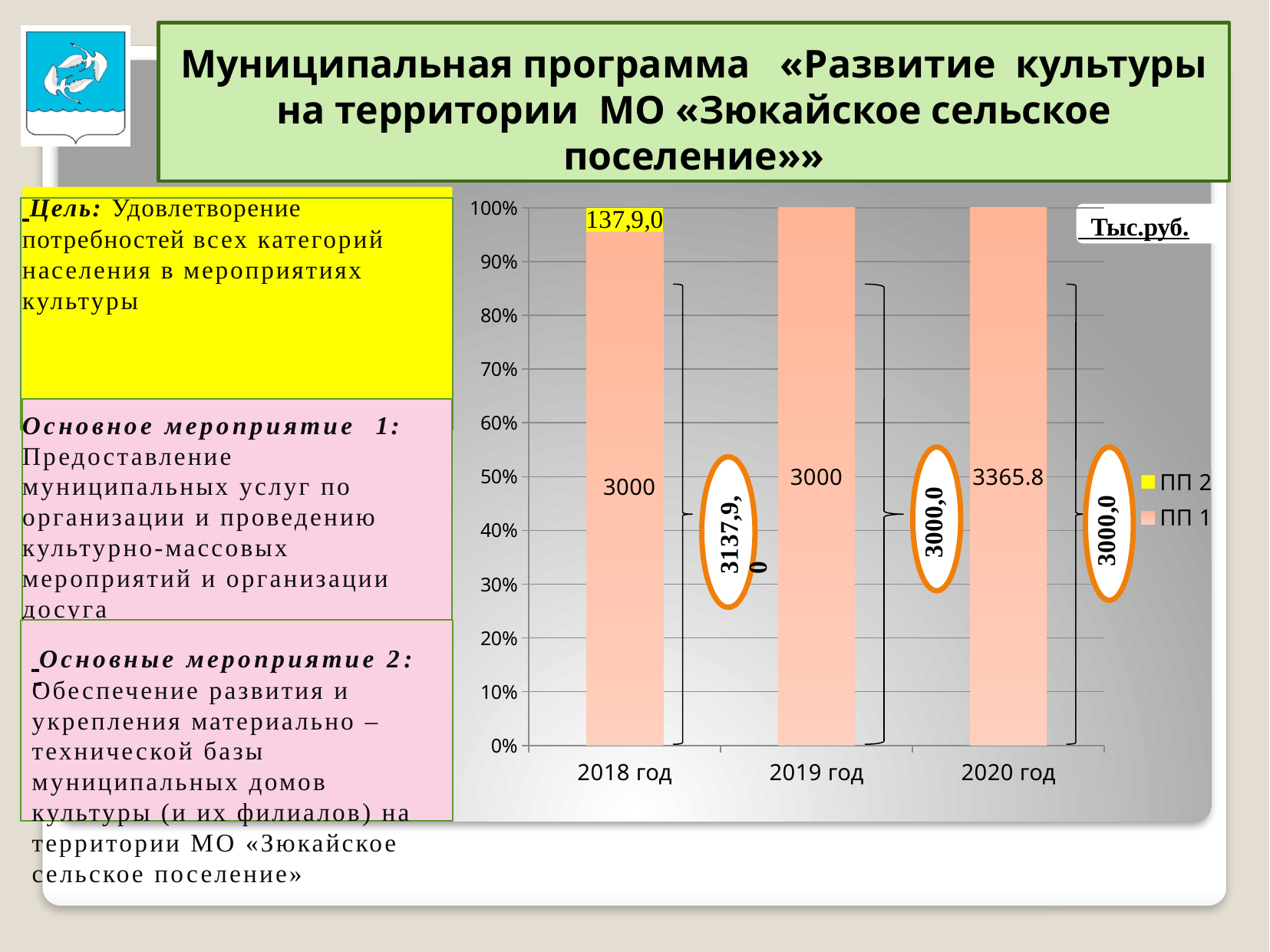
How many series does the chart legend list? 2 Which year has the larger ПП 1 value, 2019 год or 2020 год? 2020 год What is the difference between the ПП 1 values for 2020 год and 2019 год? 365.8 What are the two entries listed in the chart legend? ПП 2 and ПП 1 What data label is printed on the ПП 2 segment for 2018 год? 137,9,0 What kind of chart is shown on the slide? bar chart How many year categories are shown on the x axis of the chart? 3 What unit is indicated in the box at the top right of the chart? Тыс.руб. What is the value of ПП 1 for 2019 год? 3000 What is the value of ПП 1 for 2020 год? 3365.8 In which year is the ПП 1 value the highest? 2020 год What is the value of ПП 1 for 2018 год? 3000